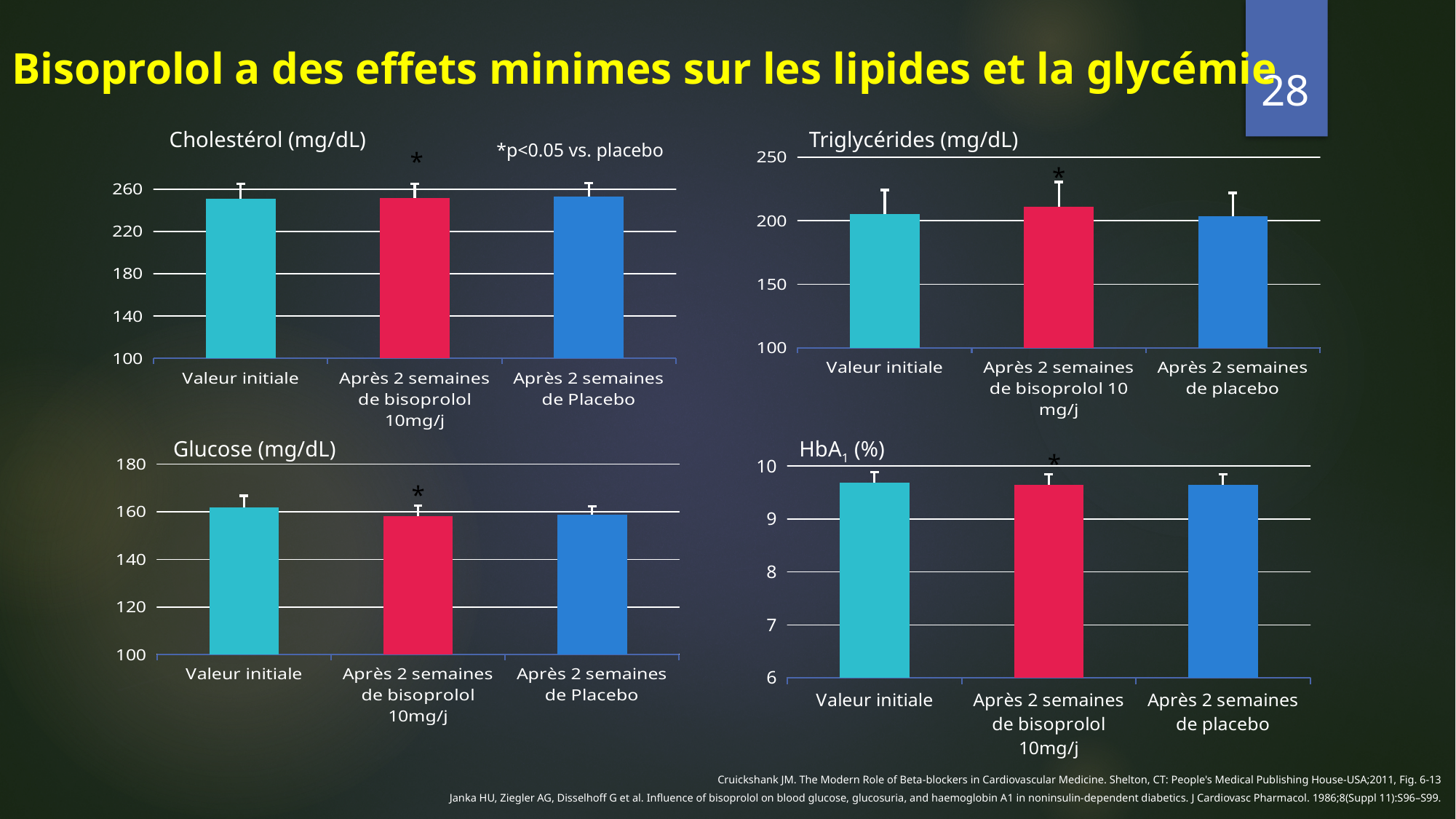
In the Triglycérides (mg/dL) chart, is the value for Après 2 semaines de bisoprolol 10 mg/j greater or less than 200? greater In the Glucose (mg/dL) chart, is the value for Après 2 semaines de bisoprolol 10mg/j greater or less than 140? greater How many categories are shown on the Triglycérides (mg/dL) chart? 3 In the Cholestérol (mg/dL) chart, is the value for Valeur initiale greater or less than 220? greater What colour is the bar for Après 2 semaines de bisoprolol 10mg/j in the Cholestérol (mg/dL) chart? red What is the title of the chart in the bottom-left of the slide? Glucose (mg/dL) How many charts are shown on the slide? 4 What kind of chart is the Cholestérol (mg/dL) chart? bar chart